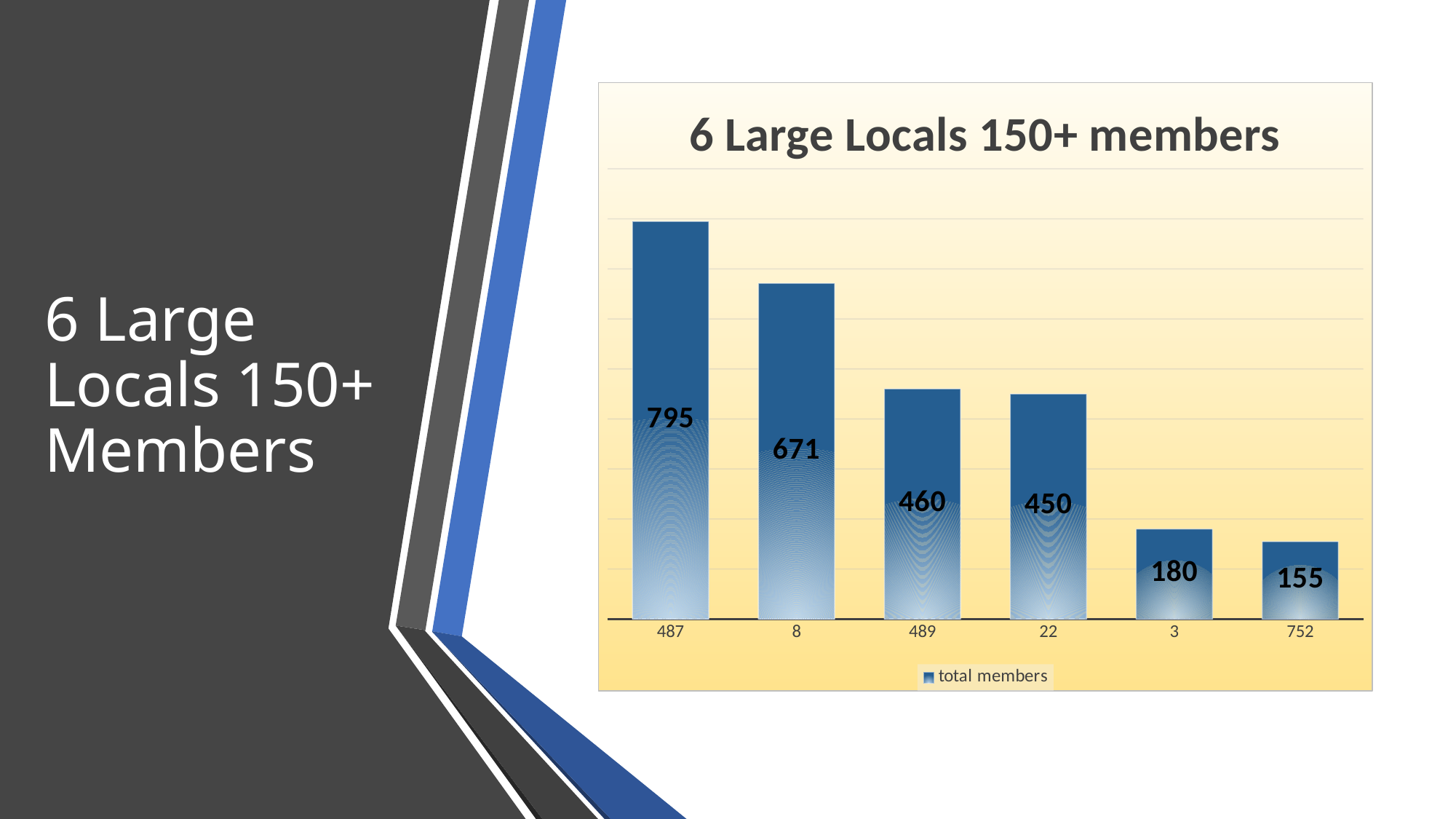
What is the difference in total members between local 487 and local 8? 124 What is the total members value for local 8? 671 What is the title of the chart? 6 Large Locals 150+ members Which local has the highest total members? 487 What is the total members value for local 487? 795 Which has more total members, local 3 or local 752? 3 What kind of chart is shown? bar chart What is the difference in total members between local 489 and local 22? 10 Which local has the lowest total members? 752 How many series does the legend list? 1 What is the total members value for local 752? 155 How many locals are shown in the chart? 6